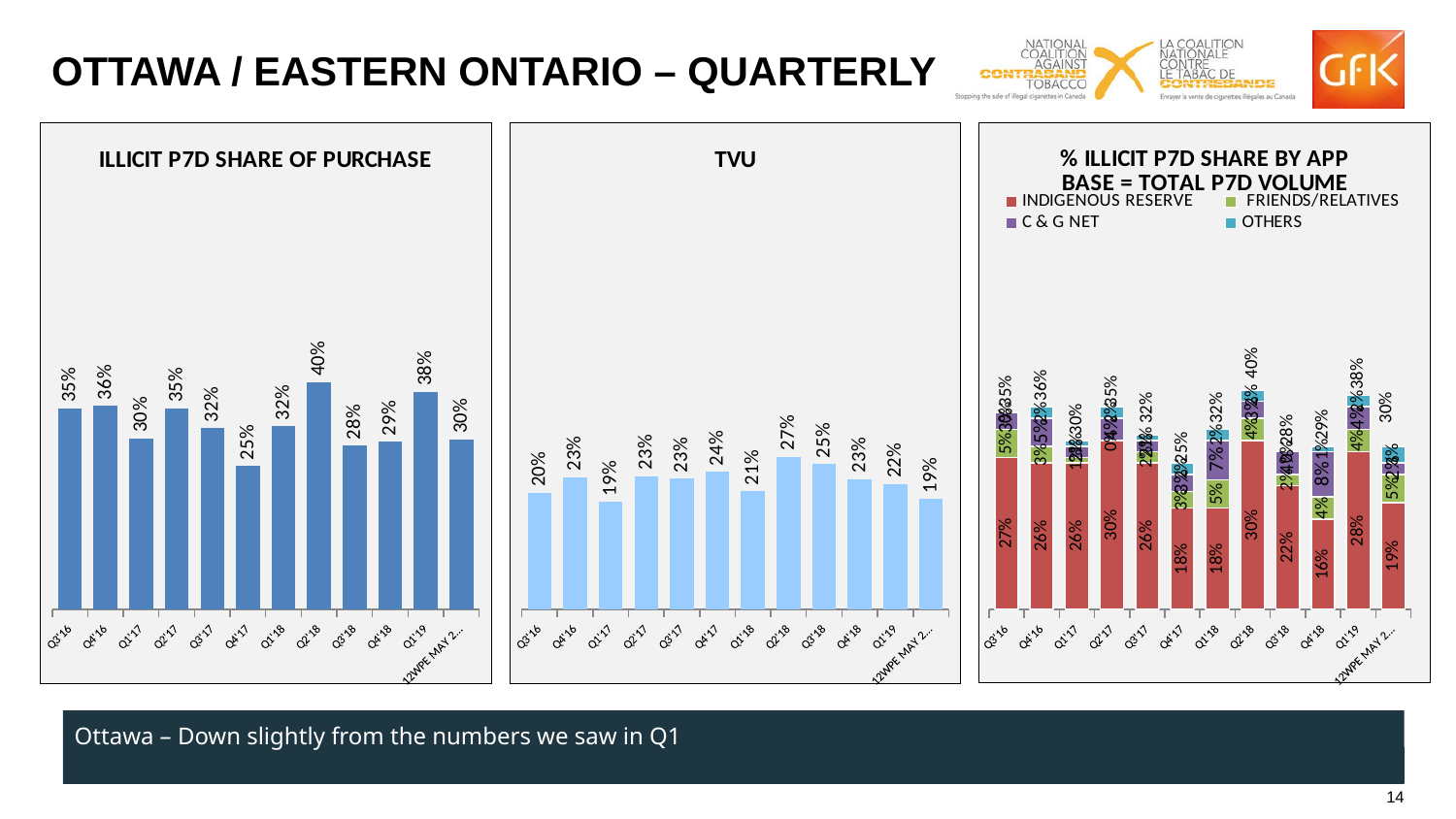
In the TVU chart, is the value for Q4'17 larger or smaller than the value for Q1'18? larger In the TVU chart, what is the value for Q2'18? 27% In the % ILLICIT P7D SHARE BY APP chart, how many series does the legend list? 4 In the % ILLICIT P7D SHARE BY APP chart, which series is shown in red? INDIGENOUS RESERVE In the ILLICIT P7D SHARE OF PURCHASE chart, which quarter has the lowest value? Q4'17 In the TVU chart, what is the difference between the Q3'18 value and the Q1'17 value? 6% What kind of chart is the TVU chart? bar chart In the TVU chart, which quarter has the highest value? Q2'18 In the ILLICIT P7D SHARE OF PURCHASE chart, what is the value for Q2'18? 40% In the % ILLICIT P7D SHARE BY APP chart, what is the INDIGENOUS RESERVE value for Q4'18? 16% In the ILLICIT P7D SHARE OF PURCHASE chart, how many bars are plotted? 12 In the ILLICIT P7D SHARE OF PURCHASE chart, what is the difference between the Q1'19 value and the Q4'18 value? 9%